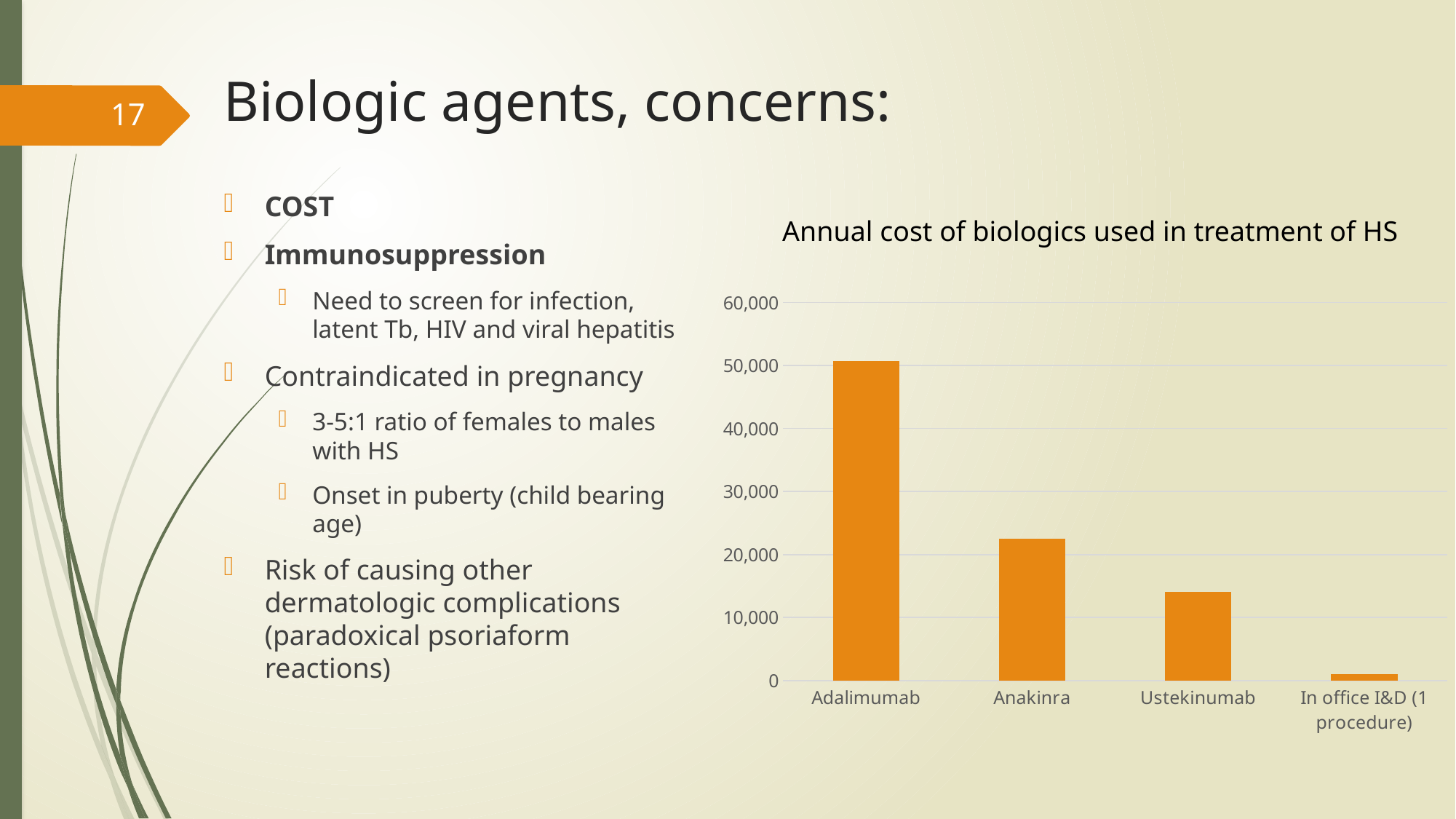
How many categories are shown on the x axis of the chart? 4 Is the value for Adalimumab greater or less than 40,000? greater Which has a higher annual cost, Anakinra or Ustekinumab? Anakinra Is the value for Ustekinumab greater or less than 20,000? less Which has a higher annual cost, Adalimumab or Anakinra? Adalimumab What type of chart is shown on the slide? bar chart Do the bar values rise or fall from left to right along the x axis? fall Is the value for Anakinra greater or less than 20,000? greater Which category has the highest annual cost in the chart? Adalimumab What is the title of the chart? Annual cost of biologics used in treatment of HS Which category has the lowest annual cost in the chart? In office I&D (1 procedure)